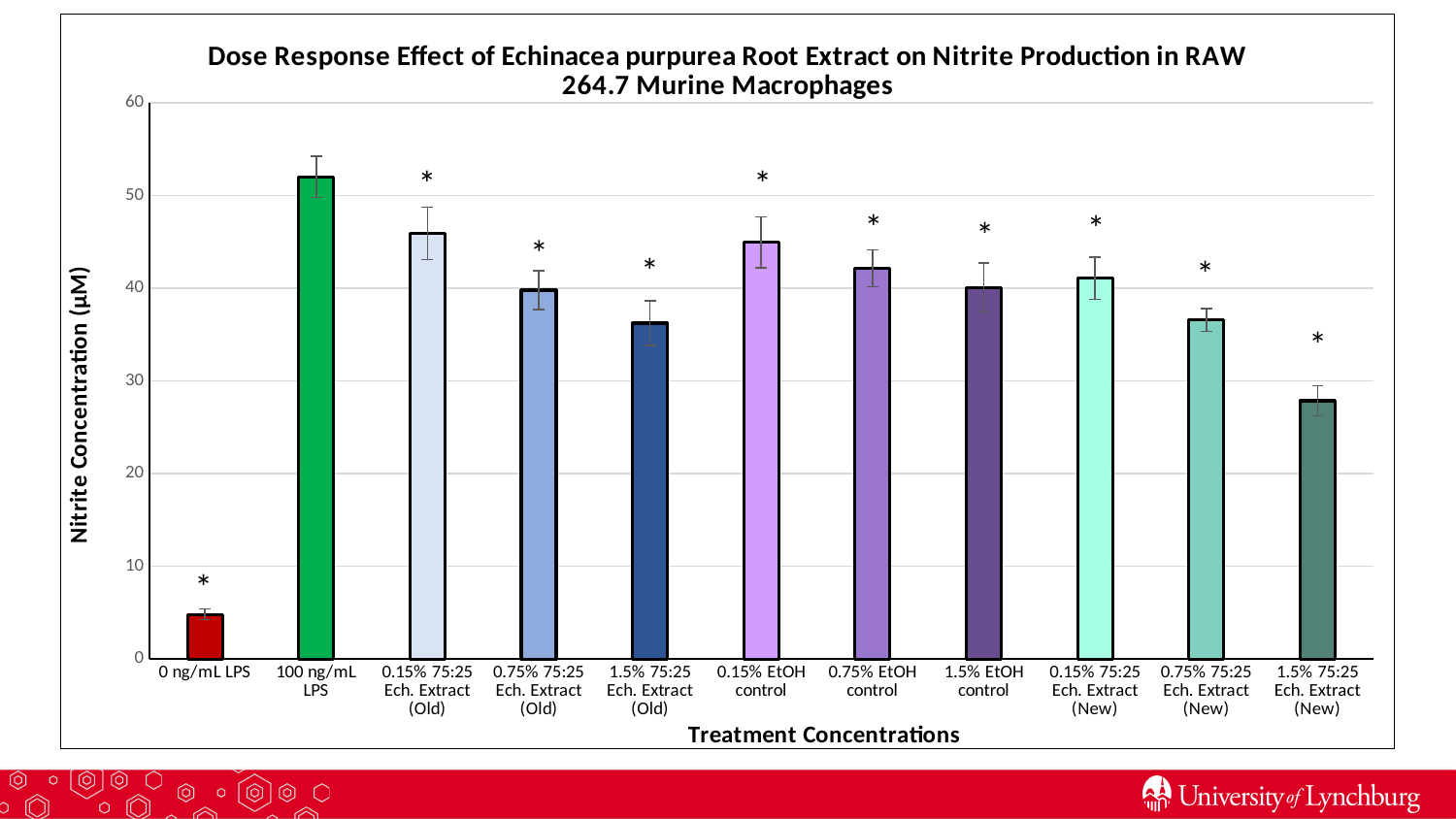
Is the value for 100 ng/mL LPS greater or less than 50? greater Which is larger, the value for 0.15% 75:25 Ech. Extract (Old) or 1.5% 75:25 Ech. Extract (Old)? 0.15% 75:25 Ech. Extract (Old) Across the three Ech. Extract (New) concentrations from 0.15% to 1.5%, do the values rise or fall? fall Which treatment has the lowest nitrite concentration? 0 ng/mL LPS Is the value for 0 ng/mL LPS greater or less than 10? less Which is larger, the value for 0.75% 75:25 Ech. Extract (New) or 1.5% 75:25 Ech. Extract (New)? 0.75% 75:25 Ech. Extract (New) What kind of chart is shown on the slide? bar chart What is the title of the y axis? Nitrite Concentration (µM) Is the value for 0.15% 75:25 Ech. Extract (Old) greater or less than 40? greater Which treatment has the highest nitrite concentration? 100 ng/mL LPS How many treatment categories are plotted on the x axis? 11